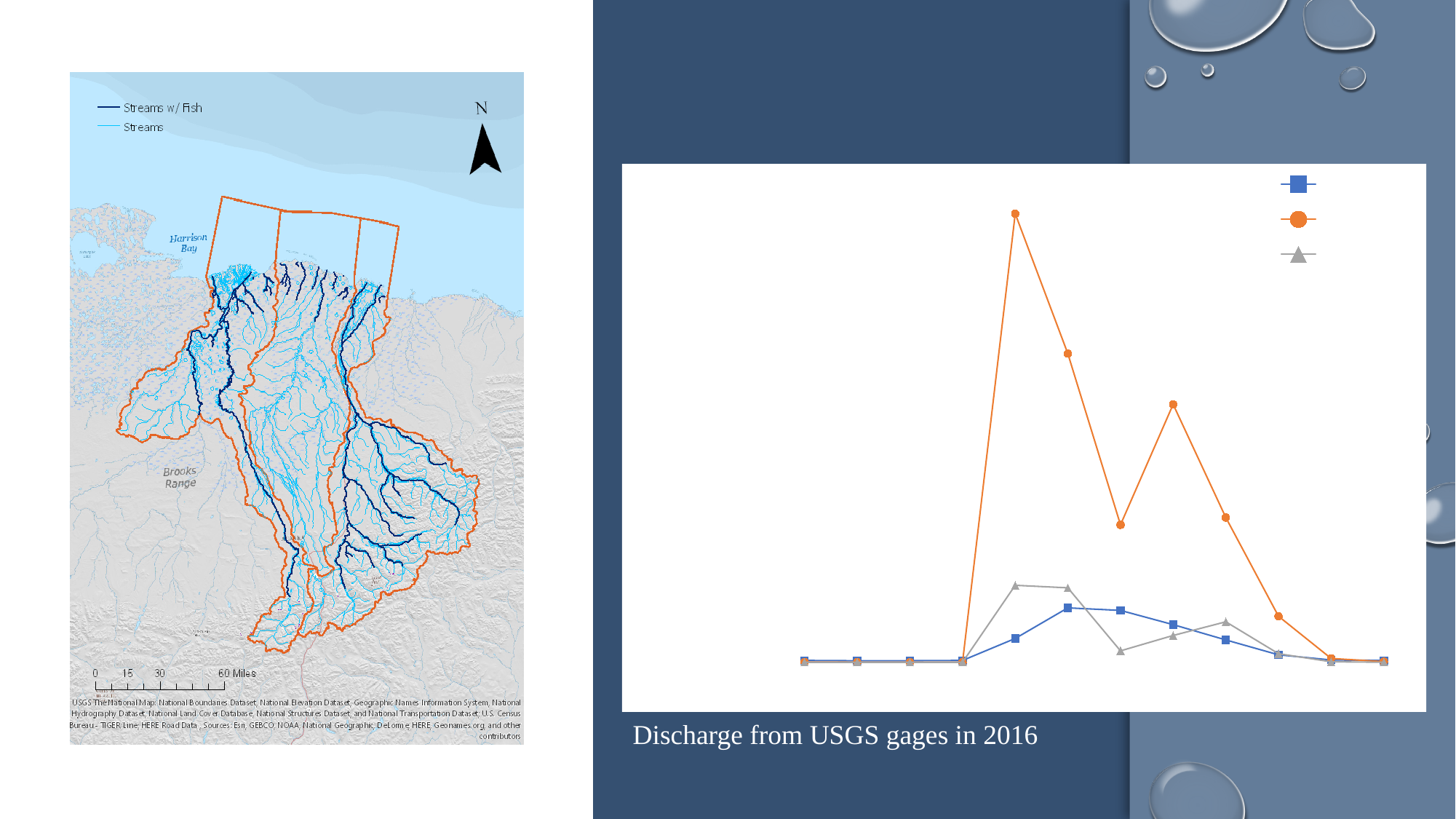
What kind of chart is shown on the right side of the slide? line chart What caption is written below the line chart? Discharge from USGS gages in 2016 At the fifth point from the left, which series is higher in the line chart: the gray series or the blue series? the gray series What marker shape is used for the blue series in the line chart? square Which series in the line chart reaches the highest value? the orange series (circle markers) Does the blue series rise or fall between the fourth and sixth points from the left? rise At the seventh point from the left, which series is higher in the line chart: the blue series or the gray series? the blue series Does the orange series rise or fall between the fifth and seventh points from the left? fall At the fifth point from the left, which series is higher in the line chart: the orange series or the blue series? the orange series Does the orange series rise or fall over the last three points on the right? fall How many data points does each series in the line chart have? 12 How many series does the legend of the line chart list? 3